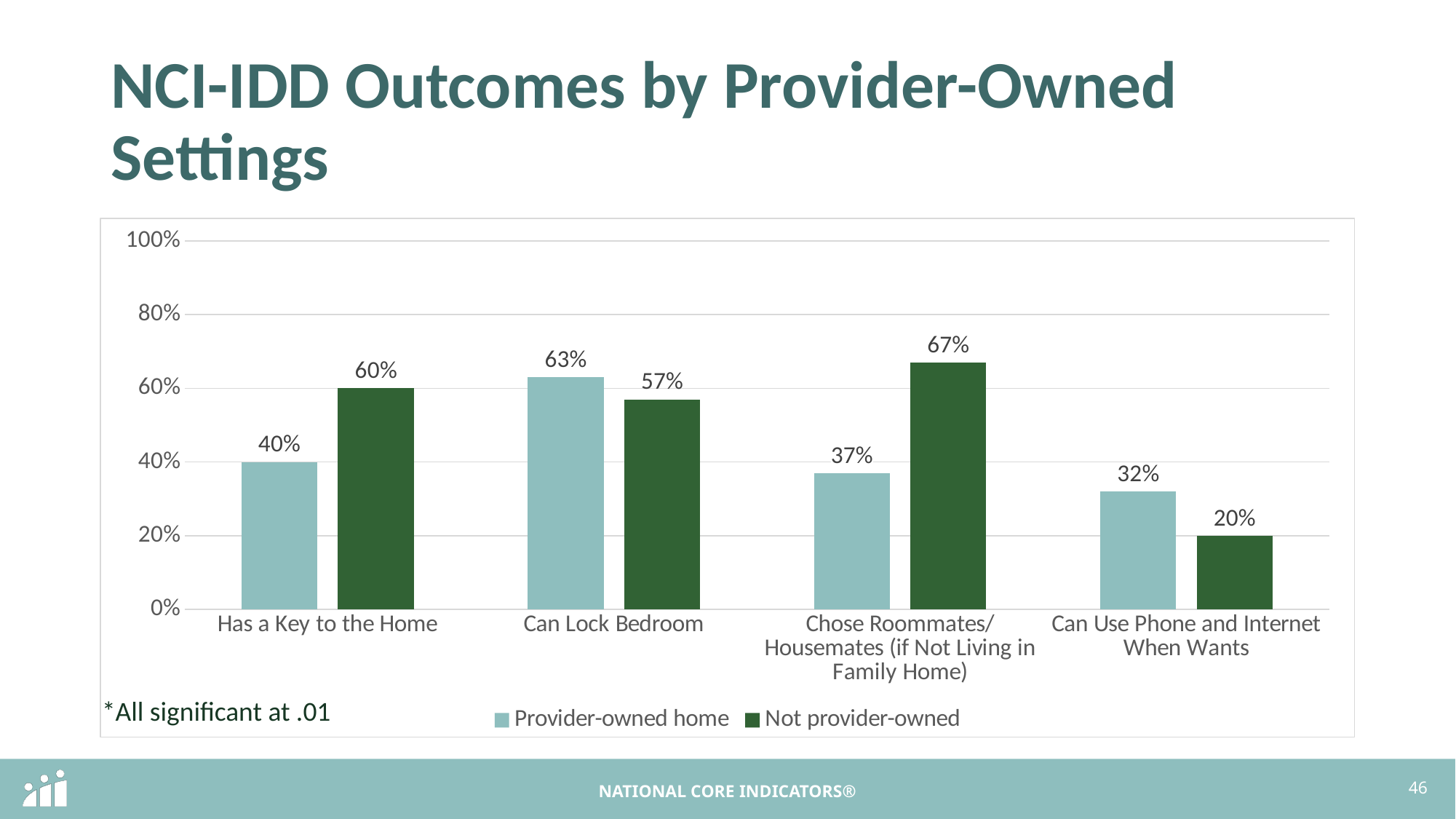
What is the value for Not provider-owned for Can Use Phone and Internet When Wants? 20% What kind of chart is shown on the slide? Bar chart What is the value for Provider-owned home for Has a Key to the Home? 40% Which category has the lowest value for the Not provider-owned series? Can Use Phone and Internet When Wants How many categories are shown on the x axis? 4 What is the difference between Not provider-owned and Provider-owned home for Has a Key to the Home? 20% What is the difference between Provider-owned home and Not provider-owned for Can Use Phone and Internet When Wants? 12% How many series does the legend list? 2 What is the value for Not provider-owned for Chose Roommates/Housemates (if Not Living in Family Home)? 67% Which category has the highest value for the Provider-owned home series? Can Lock Bedroom For Can Lock Bedroom, which series has the larger value: Provider-owned home or Not provider-owned? Provider-owned home Is the value for Not provider-owned for Can Lock Bedroom greater or less than 40%? greater